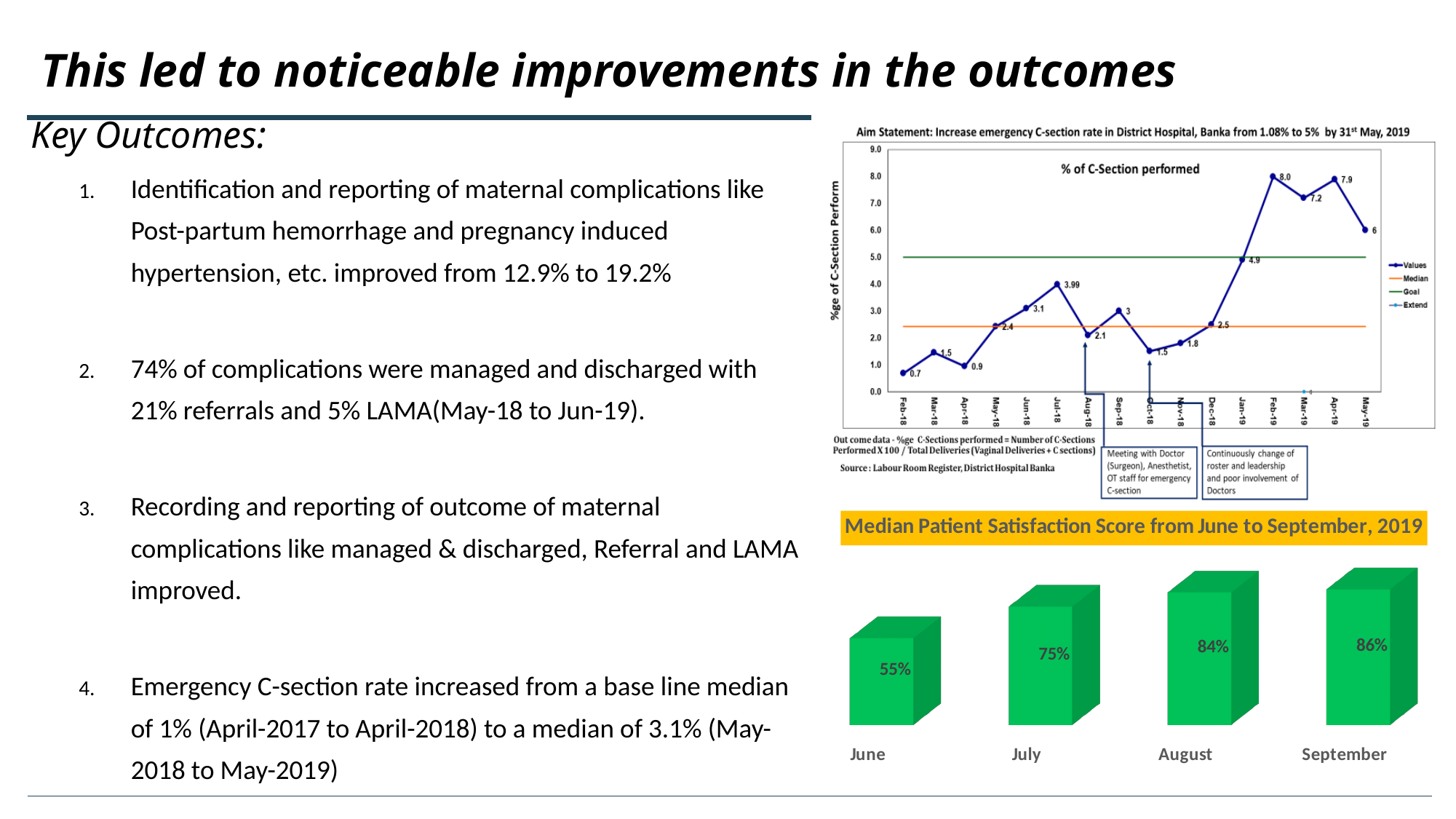
In the 'Median Patient Satisfaction Score from June to September, 2019' chart, which month has the highest score? September In the 'Median Patient Satisfaction Score from June to September, 2019' chart, do the values rise or fall from June to September? Rise What kind of chart is the 'Median Patient Satisfaction Score from June to September, 2019' chart? Bar chart In the '% of C-Section performed' line chart, what is the value for Jul-18? 3.99 In the 'Median Patient Satisfaction Score from June to September, 2019' chart, what is the difference between the July and June values? 20% In the 'Median Patient Satisfaction Score from June to September, 2019' chart, what is the value for June? 55% In the '% of C-Section performed' line chart, which month has the lowest value? Feb-18 In the 'Median Patient Satisfaction Score from June to September, 2019' chart, how many months are shown? 4 In the '% of C-Section performed' line chart, what is the value for Feb-19? 8.0 In the 'Median Patient Satisfaction Score from June to September, 2019' chart, which month has the lowest score? June In the 'Median Patient Satisfaction Score from June to September, 2019' chart, what is the value for August? 84% How many entries does the legend of the '% of C-Section performed' line chart list? 4